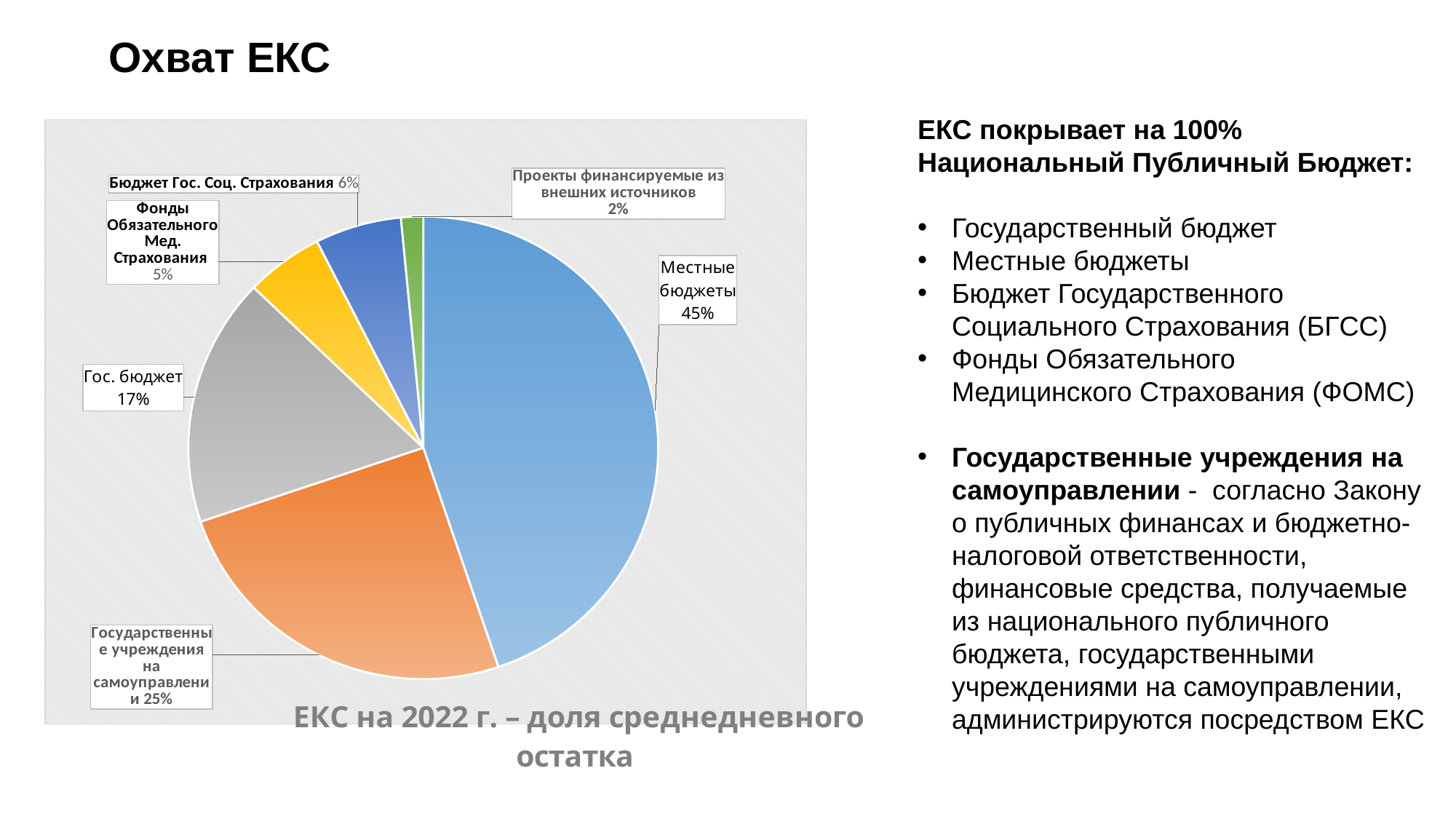
What is the share for Гос. бюджет in the pie chart? 17% What is the share for Фонды Обязательного Мед. Страхования? 5% Which is larger: Бюджет Гос. Соц. Страхования or Фонды Обязательного Мед. Страхования? Бюджет Гос. Соц. Страхования What is the title of the pie chart? ЕКС на 2022 г. – доля среднедневного остатка Which category has the largest slice in the pie chart? Местные бюджеты What is the share for Местные бюджеты in the pie chart? 45% What is the share for Государственные учреждения на самоуправлении? 25% Which category has the smallest slice in the pie chart? Проекты финансируемые из внешних источников How many slices does the pie chart have? 6 What type of chart is shown on the slide? pie chart What is the share for Проекты финансируемые из внешних источников? 2% What is the difference in percentage points between Местные бюджеты and Гос. бюджет? 28